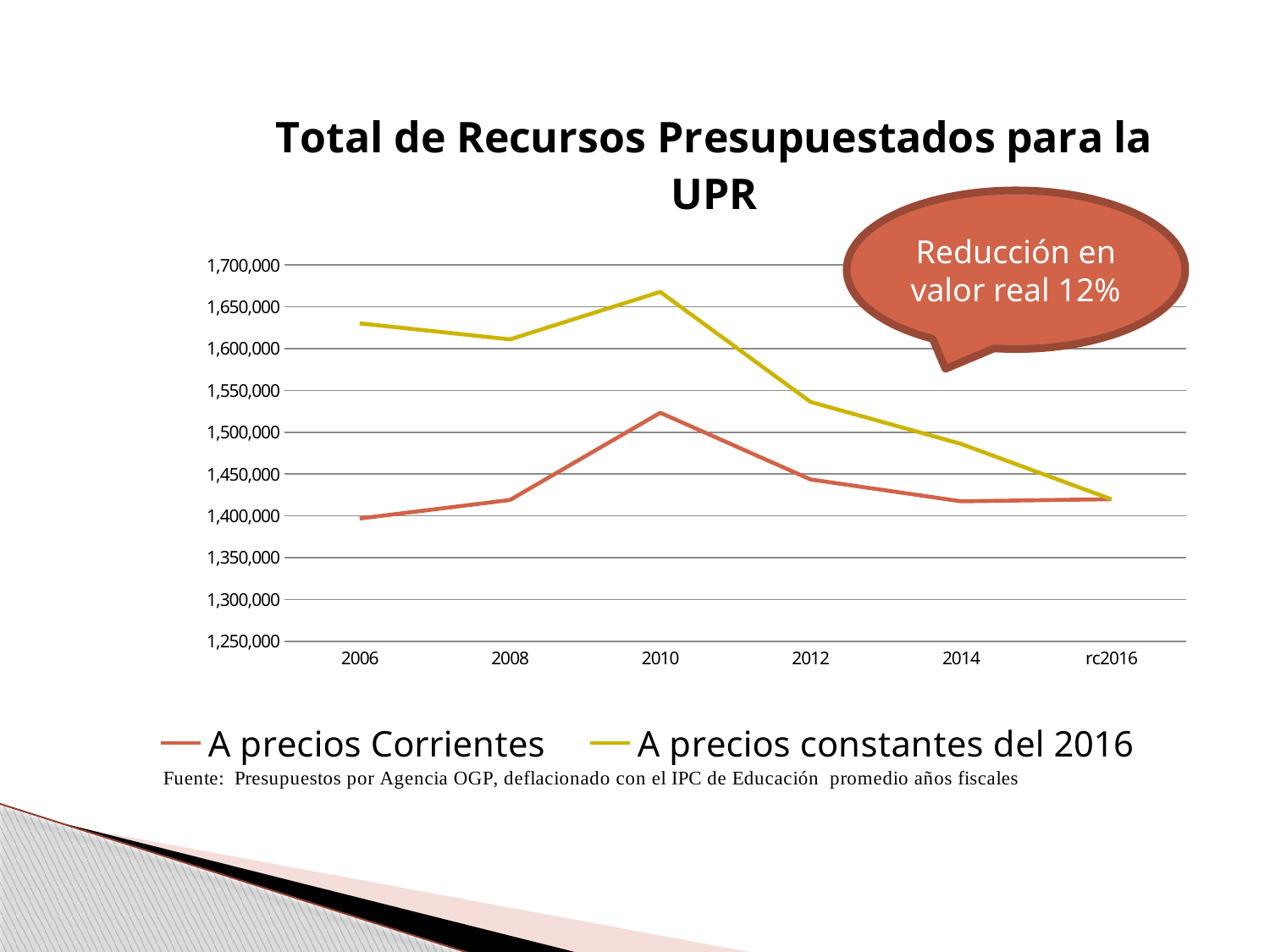
What kind of chart is shown on the slide? Line chart Is the value for 'A precios constantes del 2016' in 2014 greater or less than 1,500,000? less In which year does the 'A precios constantes del 2016' series reach its highest value? 2010 In 2010, which series has the larger value, 'A precios Corrientes' or 'A precios constantes del 2016'? A precios constantes del 2016 Does the 'A precios constantes del 2016' series rise or fall from 2010 to rc2016? Fall How many years are plotted along the x axis? 6 Is the value for 'A precios constantes del 2016' in 2010 greater or less than 1,650,000? greater In which year is the 'A precios Corrientes' series at its lowest? 2006 In which year does the 'A precios Corrientes' series reach its highest value? 2010 In which year is the 'A precios constantes del 2016' series at its lowest? rc2016 Is the value for 'A precios Corrientes' in 2010 greater or less than 1,500,000? greater How many series does the legend list? 2